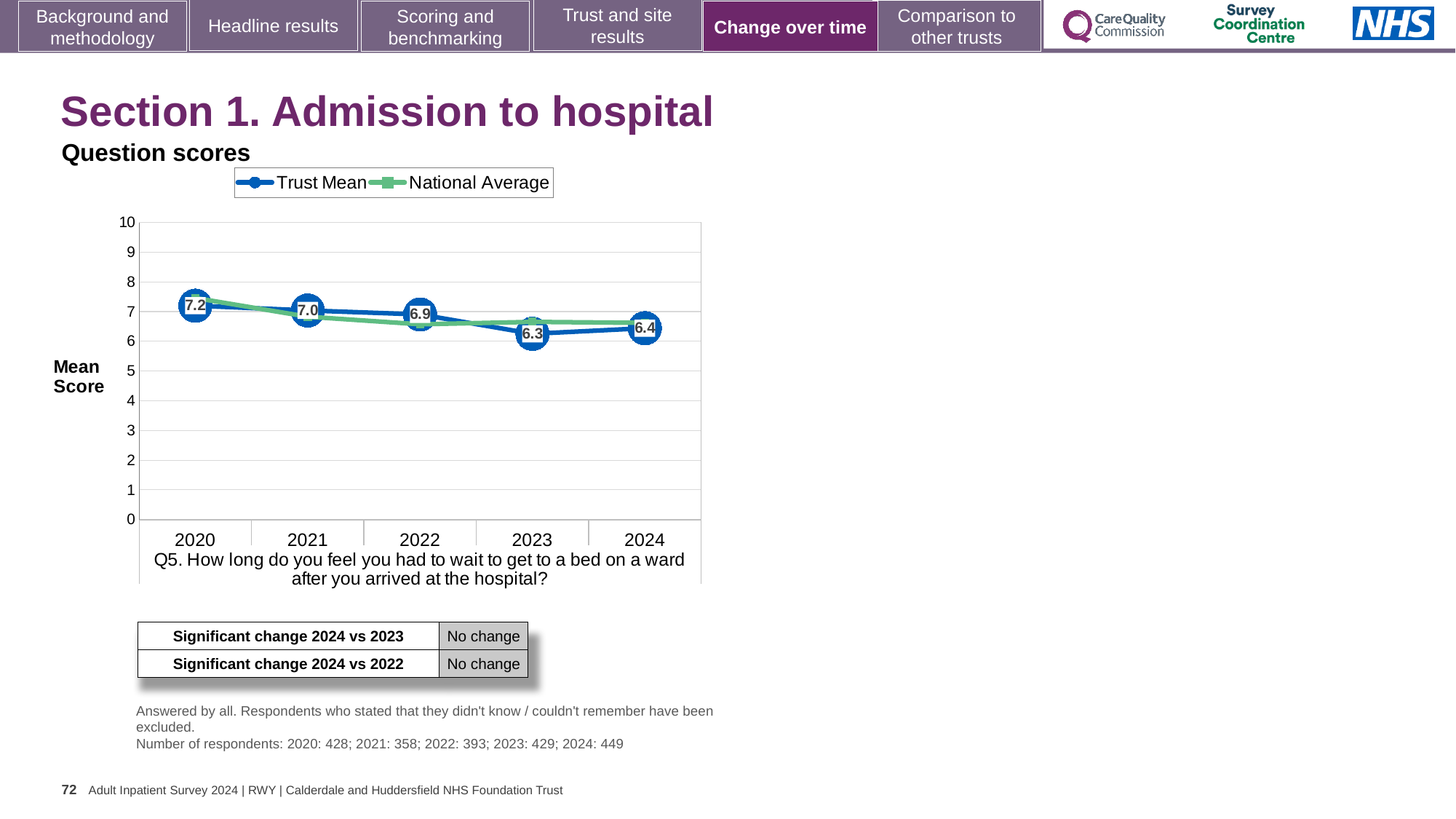
What is the Trust Mean score for 2024? 6.4 Which year has the larger Trust Mean score, 2021 or 2022? 2021 Does the Trust Mean score rise or fall overall from 2020 to 2024? Fall What is the difference between the Trust Mean score in 2020 and in 2024? 0.8 In which year is the Trust Mean score lowest? 2023 In which year is the Trust Mean score highest? 2020 How many years are plotted on the x axis? 5 How many series does the legend list? 2 What kind of chart is shown on the slide? Line chart Is the National Average value for 2024 greater or less than 7? less What is the Trust Mean score for 2023? 6.3 What is the Trust Mean score for 2020? 7.2